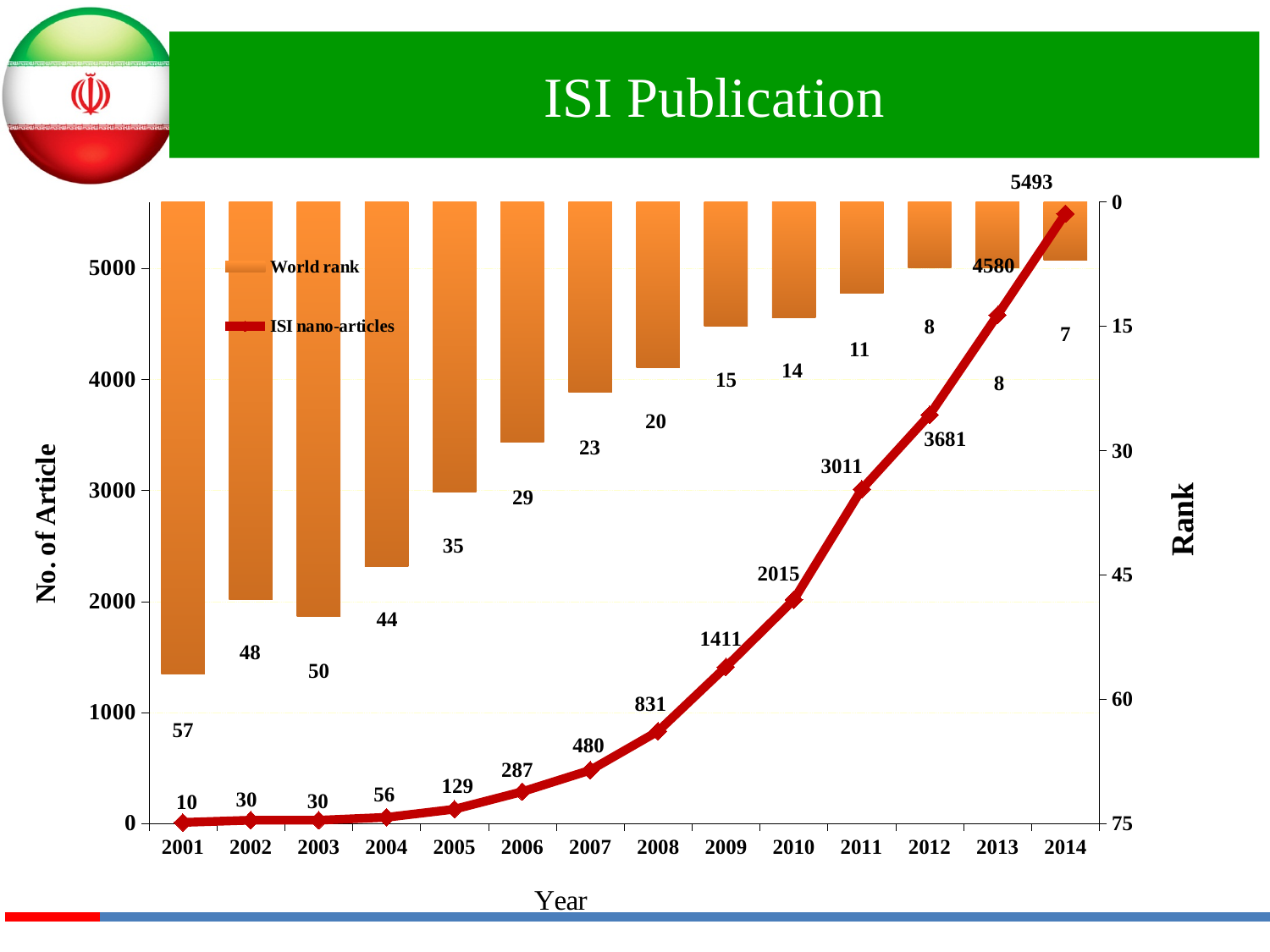
What is the difference in ISI nano-articles between 2014 and 2013? 913 How many series does the legend list? 2 What is the world rank shown for 2008? 20 Does the number of ISI nano-articles rise or fall from 2001 to 2014? rise What is the label of the left vertical axis? No. of Article How many years are shown on the x axis? 14 Which year has the lowest number of ISI nano-articles? 2001 What is the number of ISI nano-articles in 2009? 1411 Which year has the highest number of ISI nano-articles? 2014 Which year has more ISI nano-articles, 2010 or 2011? 2011 What is the number of ISI nano-articles in 2014? 5493 What is the world rank shown for 2001? 57